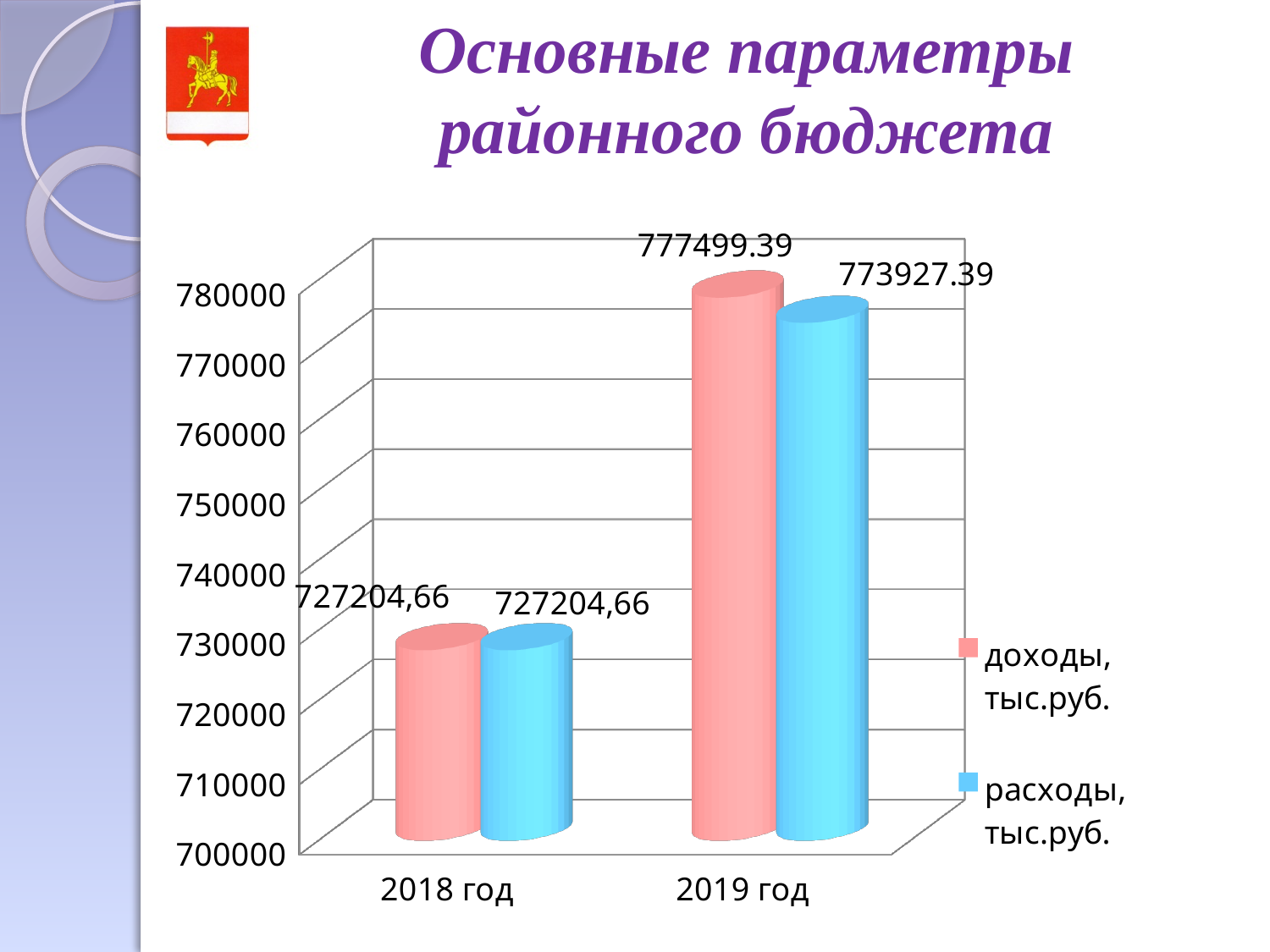
Which is larger in 2019 год: доходы, тыс.руб. or расходы, тыс.руб.? доходы, тыс.руб. What is the value for доходы, тыс.руб. in 2019 год? 777499.39 What is the value for расходы, тыс.руб. in 2019 год? 773927.39 What is the value for расходы, тыс.руб. in 2018 год? 727204,66 How many series does the legend list? 2 What is the difference between доходы, тыс.руб. and расходы, тыс.руб. in 2019 год? 3572 Is the value for расходы, тыс.руб. in 2018 год greater or less than 740000? less Do the values for доходы, тыс.руб. rise or fall from 2018 год to 2019 год? rise What kind of chart is shown on the slide? bar chart In which year is the value for расходы, тыс.руб. lowest? 2018 год What is the value for доходы, тыс.руб. in 2018 год? 727204,66 In which year is the value for доходы, тыс.руб. highest? 2019 год